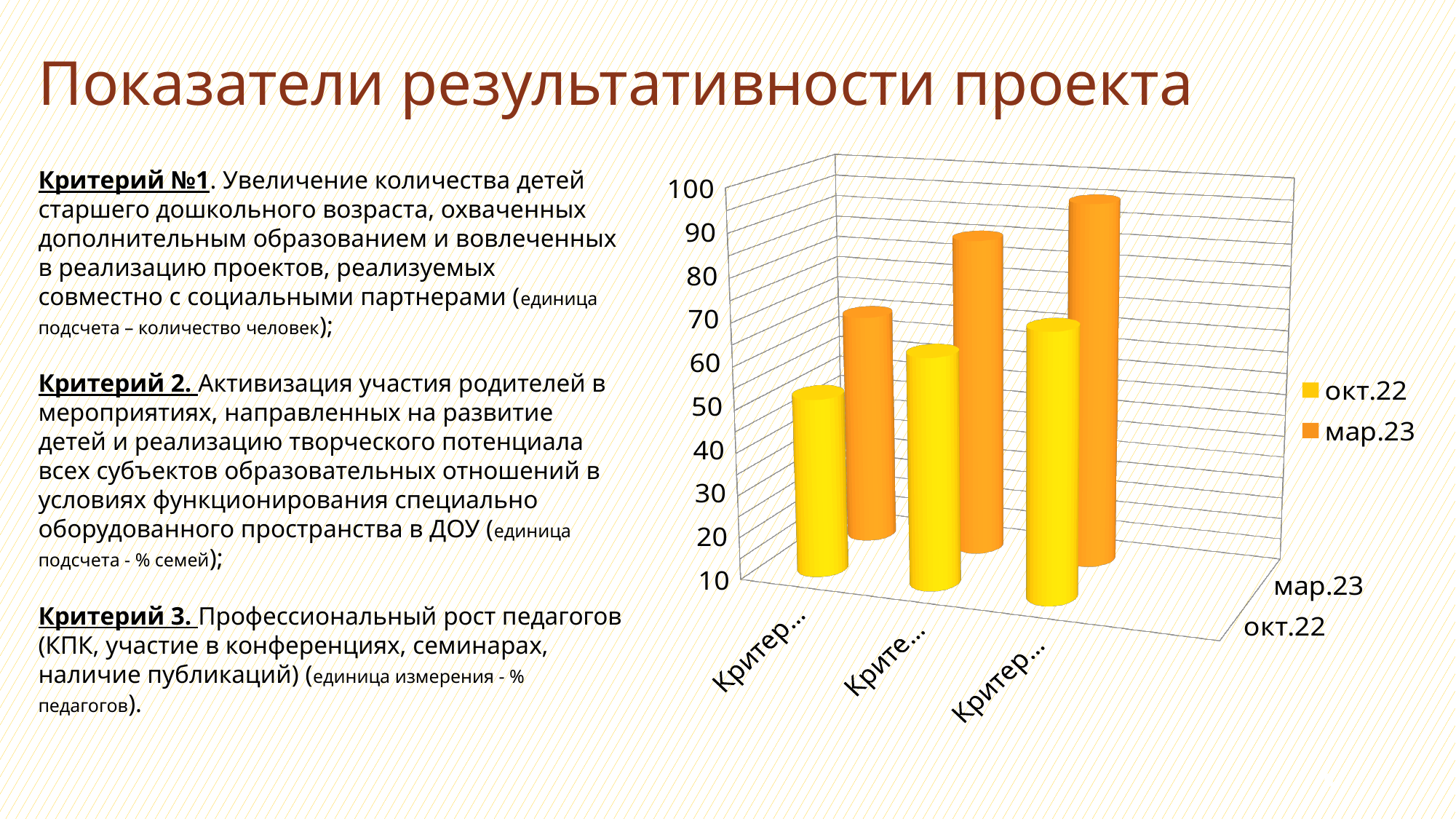
Which series contains the tallest bar in the chart? мар.23 What are the two series named in the chart legend? окт.22 and мар.23 What kind of chart is shown on the slide? bar chart In every category, which series has the taller bar, окт.22 or мар.23? мар.23 How many series does the chart legend list? 2 How many categories (criteria) are plotted along the x axis of the chart? 3 Which series is shown in yellow in the chart? окт.22 What is the highest value shown on the chart's vertical axis? 100